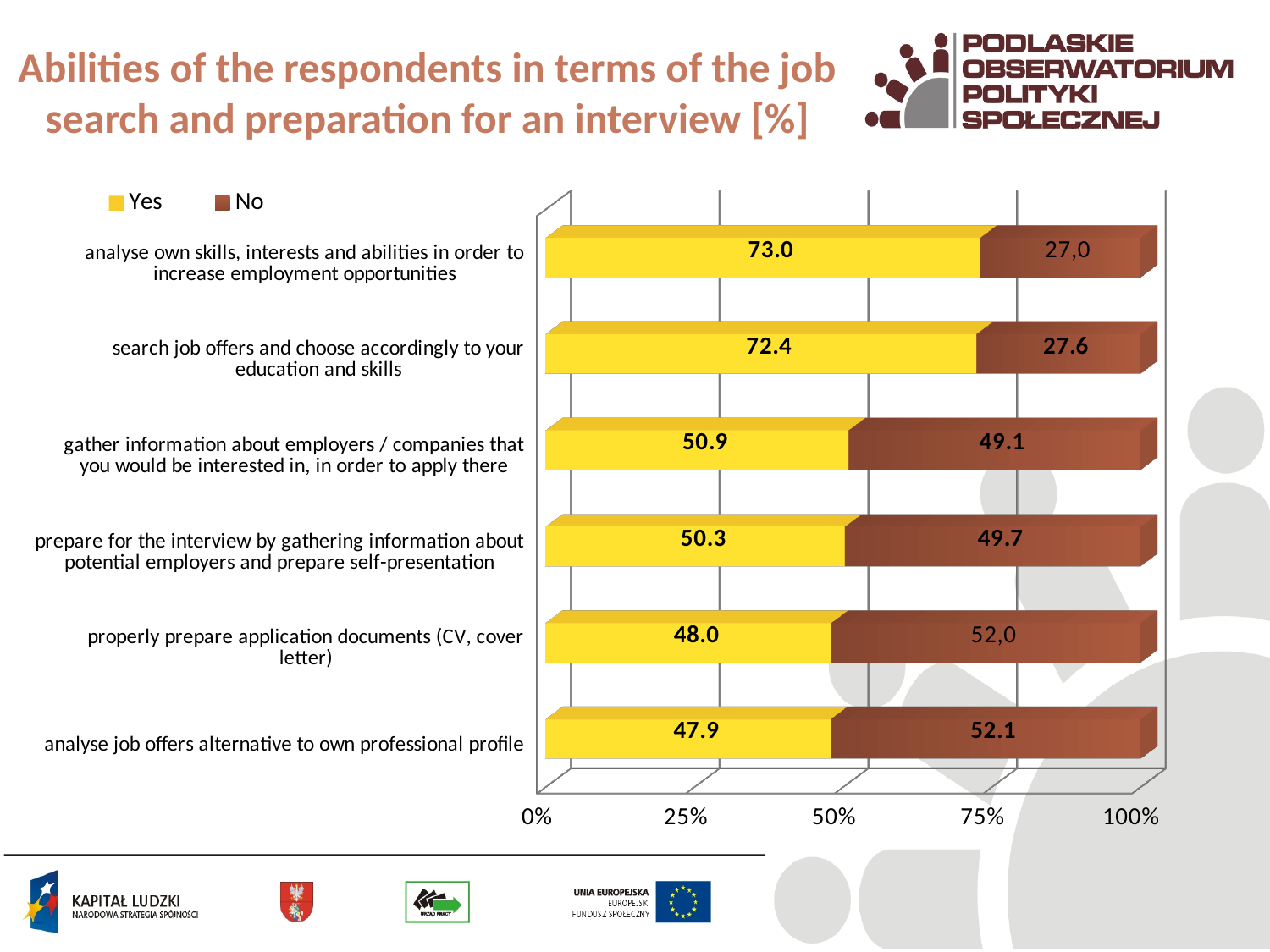
What kind of chart is shown on the slide? stacked bar chart What is the difference between the "Yes" and "No" values for "gather information about employers / companies that you would be interested in, in order to apply there"? 1.8 How many series does the legend list? 2 What is the "No" value for "search job offers and choose accordingly to your education and skills"? 27.6 What is the "Yes" value for "analyse own skills, interests and abilities in order to increase employment opportunities"? 73.0 What is the "No" value for "properly prepare application documents (CV, cover letter)"? 52,0 Which colour represents the "No" series in the chart? brown Which category has the lowest "Yes" value? analyse job offers alternative to own professional profile What is the "Yes" value for "analyse job offers alternative to own professional profile"? 47.9 Which category has the highest "Yes" value? analyse own skills, interests and abilities in order to increase employment opportunities How many categories are shown on the chart? 6 Which is larger for "prepare for the interview by gathering information about potential employers and prepare self-presentation": the "Yes" value or the "No" value? Yes